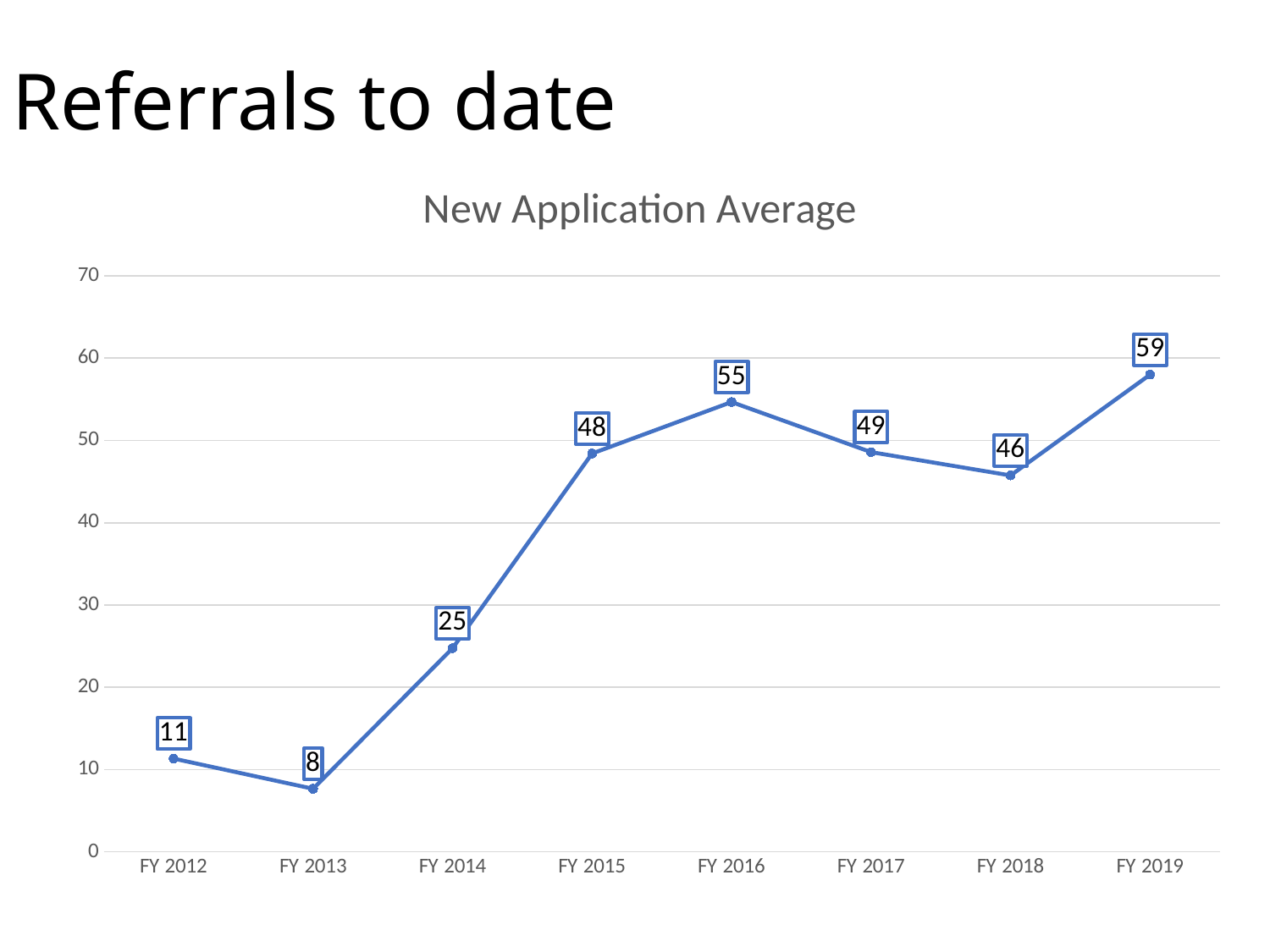
What is the difference between the values for FY 2019 and FY 2012? 48 What is the value for FY 2016? 55 What kind of chart is shown on the slide? line chart Which fiscal year has the highest value? FY 2019 Which fiscal year has the lowest value? FY 2013 Which is larger, the value for FY 2016 or the value for FY 2017? FY 2016 What is the title of the chart? New Application Average What is the value for FY 2012? 11 Is the value for FY 2015 greater or less than 40? greater What is the value for FY 2018? 46 How many fiscal years are plotted on the chart? 8 What is the difference between the values for FY 2015 and FY 2014? 23